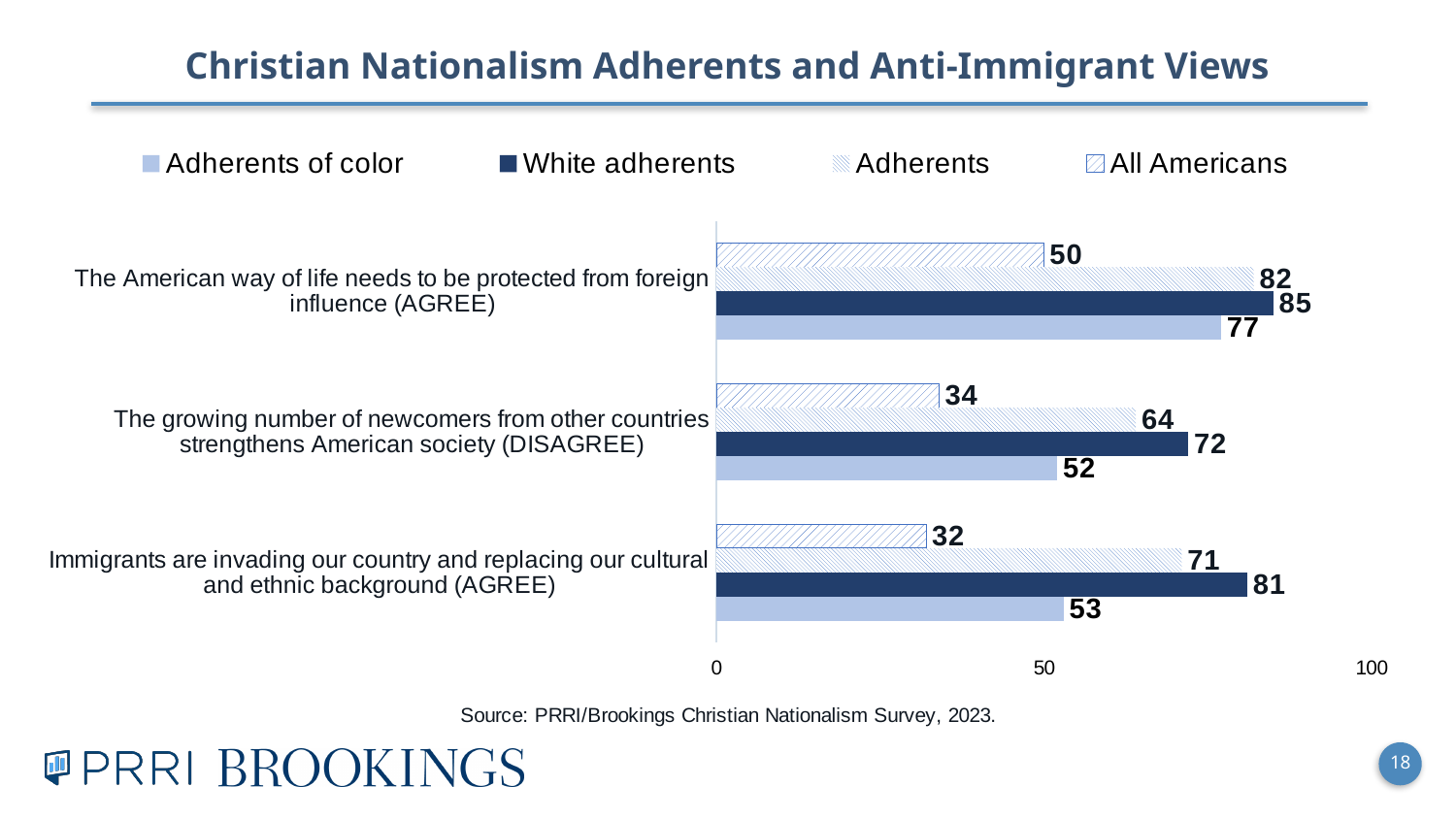
Which series has the highest value for 'Immigrants are invading our country and replacing our cultural and ethnic background (AGREE)'? White adherents What is the value for All Americans on 'Immigrants are invading our country and replacing our cultural and ethnic background (AGREE)'? 32 How many statements (categories) are shown on the chart? 3 Is the value for All Americans on 'The growing number of newcomers from other countries strengthens American society (DISAGREE)' greater or less than 50? less What is the value for Adherents of color on 'The growing number of newcomers from other countries strengthens American society (DISAGREE)'? 52 What kind of chart is shown on the slide? Bar chart What is the title of the chart? Christian Nationalism Adherents and Anti-Immigrant Views What is the difference between White adherents and All Americans on 'The growing number of newcomers from other countries strengthens American society (DISAGREE)'? 38 What is the value for White adherents on 'The American way of life needs to be protected from foreign influence (AGREE)'? 85 Which is larger for 'Immigrants are invading our country and replacing our cultural and ethnic background (AGREE)': Adherents or Adherents of color? Adherents How many series does the legend list? 4 Which series has the lowest value for 'The American way of life needs to be protected from foreign influence (AGREE)'? All Americans